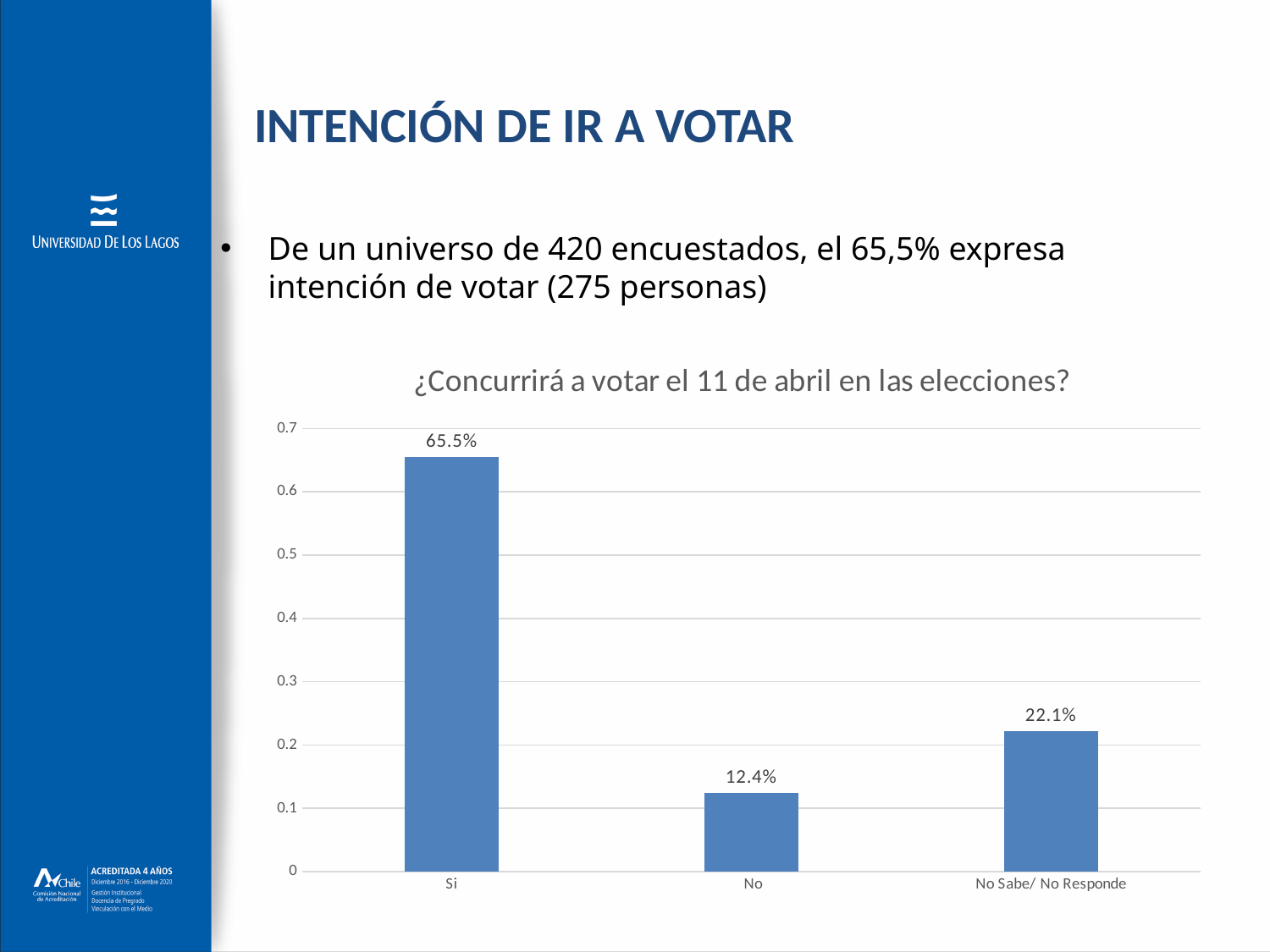
What is the title of the chart? ¿Concurrirá a votar el 11 de abril en las elecciones? What kind of chart is shown on the slide? bar chart How many categories are shown on the x axis? 3 What is the difference between the values for "No Sabe/ No Responde" and "No"? 9.7% Is the value for "Si" greater or less than 0.6? greater What is the value for "No Sabe/ No Responde"? 22.1% What is the difference between the values for "Si" and "No"? 53.1% Which category has the lowest value? No Which category has the highest value? Si Which is larger, the value for "No" or the value for "No Sabe/ No Responde"? No Sabe/ No Responde What is the value for "Si"? 65.5% What is the value for "No"? 12.4%